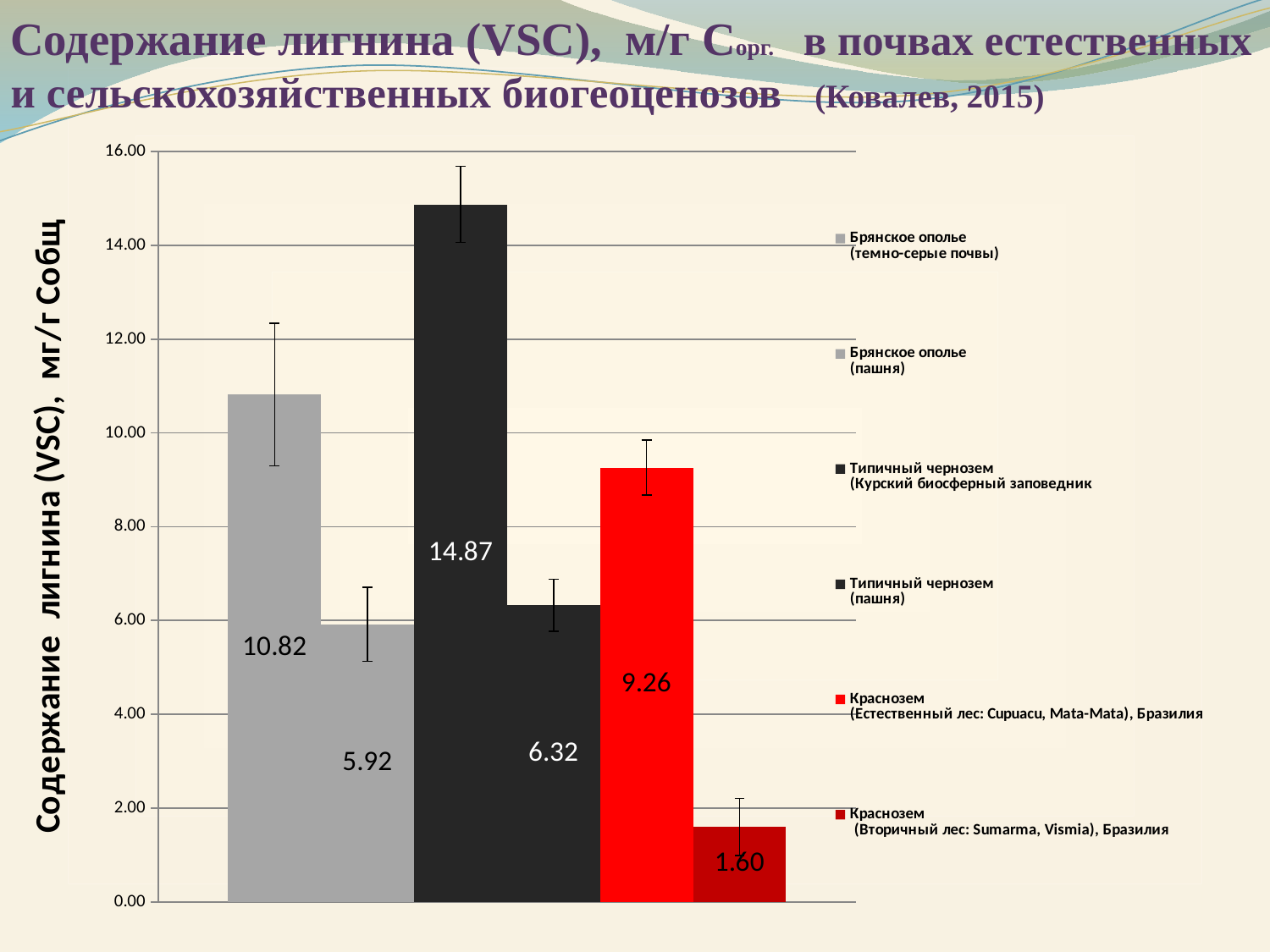
Is the value for Краснозем (Естественный лес: Cupuacu, Mata-Mata), Бразилия greater or less than 8.00? greater How many series does the legend list? 6 Which series has the lowest lignin content? Краснозем (Вторичный лес: Sumarma, Vismia), Бразилия What is the lignin content value for Краснозем (Вторичный лес: Sumarma, Vismia), Бразилия? 1.60 What is the difference between the lignin content of Типичный чернозем (Курский биосферный заповедник) and Типичный чернозем (пашня)? 8.55 Which series has the highest lignin content? Типичный чернозем (Курский биосферный заповедник) What is the lignin content value for Брянское ополье (темно-серые почвы)? 10.82 What is the lignin content value for Типичный чернозем (Курский биосферный заповедник)? 14.87 How many bars are plotted in the chart? 6 What is the lignin content value for Типичный чернозем (пашня)? 6.32 What kind of chart is shown on the slide? bar chart Which has a higher lignin content: Брянское ополье (пашня) or Типичный чернозем (пашня)? Типичный чернозем (пашня)